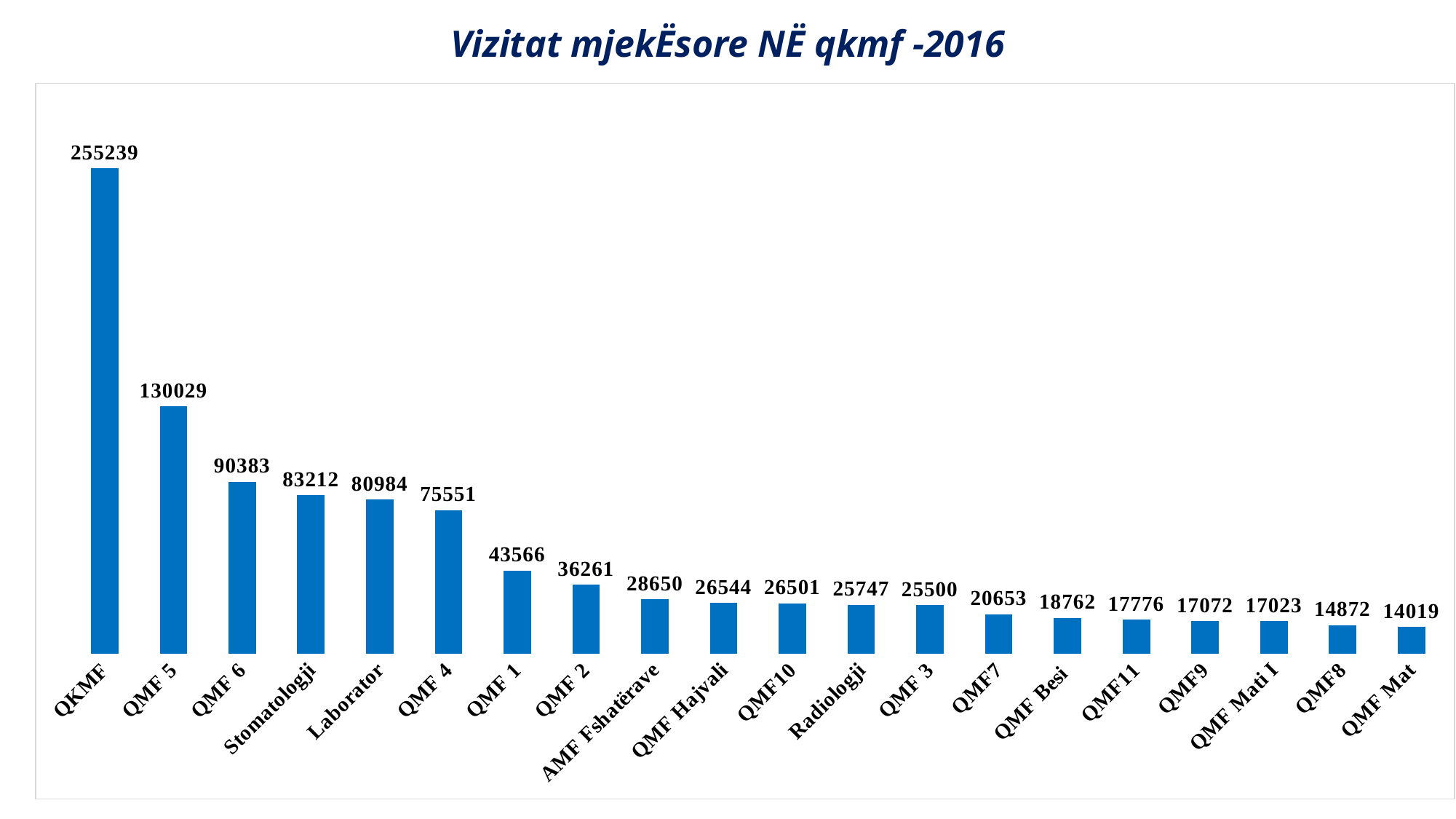
Which category has the lowest value? QMF Mat What kind of chart is shown on the slide? Bar chart Which is larger, the value for Laborator or the value for QMF 4? Laborator What is the difference between the values for QKMF and QMF 5? 125210 Which category has the highest value? QKMF What is the value for QMF Hajvali? 26544 What is the value for QMF Mat? 14019 What is the difference between the values for QMF 1 and QMF 2? 7305 What is the title of the chart? Vizitat mjekËsore NË qkmf -2016 What is the value for QKMF? 255239 How many categories are shown in the chart? 20 What is the value for Stomatologji? 83212